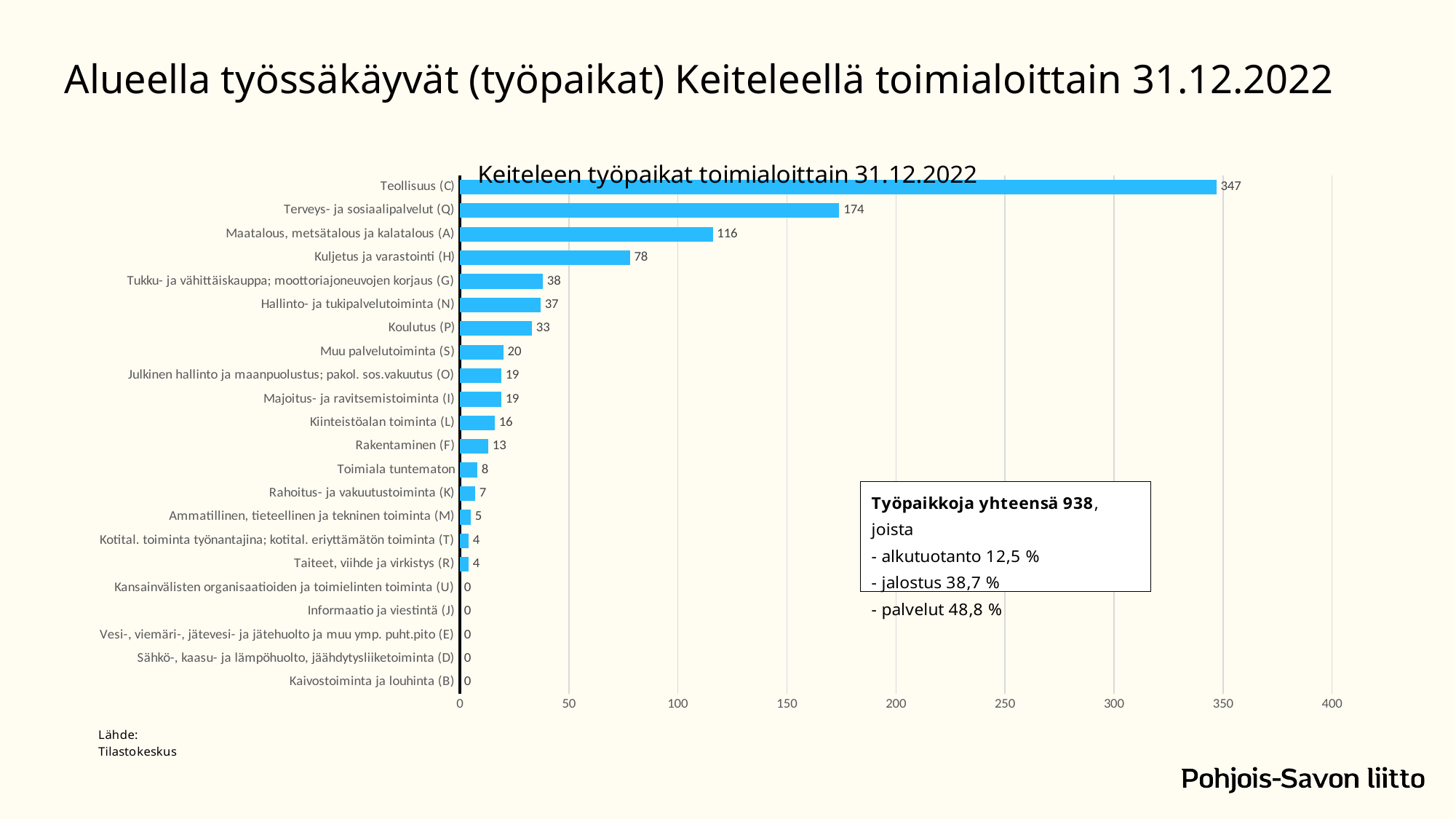
What is the value for Kuljetus ja varastointi (H)? 78 What is the value for Terveys- ja sosiaalipalvelut (Q)? 174 What is the difference between the values for Teollisuus (C) and Terveys- ja sosiaalipalvelut (Q)? 173 Which category has the highest value? Teollisuus (C) What is the difference between the values for Maatalous, metsätalous ja kalatalous (A) and Kuljetus ja varastointi (H)? 38 What is the value for Rakentaminen (F)? 13 Which is larger, the value for Koulutus (P) or the value for Muu palvelutoiminta (S)? Koulutus (P) What kind of chart is shown on the slide? bar chart How many categories are shown in the chart? 22 What is the title of the chart? Keiteleen työpaikat toimialoittain 31.12.2022 How many categories have a value of 0? 5 What is the value for Teollisuus (C)? 347